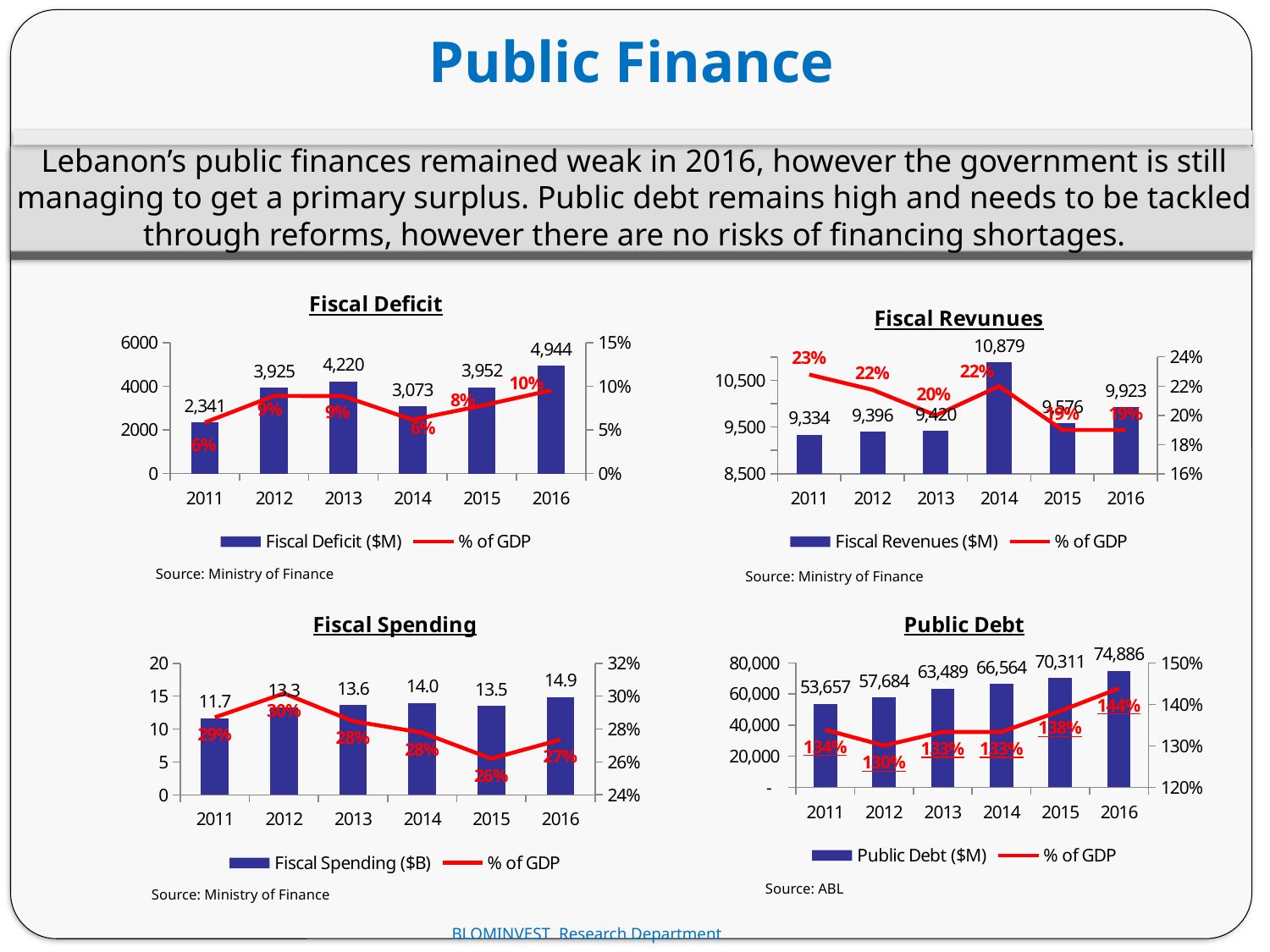
In the Fiscal Deficit chart, what is the % of GDP value for 2016? 10% In the Fiscal Deficit chart, what is the fiscal deficit in $M for 2016? 4,944 In the Public Debt chart, what is the % of GDP value for 2012? 130% In the Public Debt chart, what is the public debt in $M for 2016? 74,886 In the Fiscal Revunues chart, what is the % of GDP value for 2011? 23% In the Fiscal Revunues chart, what is the difference in fiscal revenues ($M) between 2014 and 2013? 1,459 In the Fiscal Revunues chart, which year has the highest fiscal revenues? 2014 In the Public Debt chart, does public debt rise or fall from 2011 to 2016? rise In the Fiscal Deficit chart, which year has the lowest fiscal deficit? 2011 In the Fiscal Spending chart, what is the fiscal spending in $B for 2015? 13.5 How many years are shown on the x axis of the Fiscal Spending chart? 6 In the Fiscal Spending chart, which is larger, fiscal spending in 2013 or in 2014? 2014